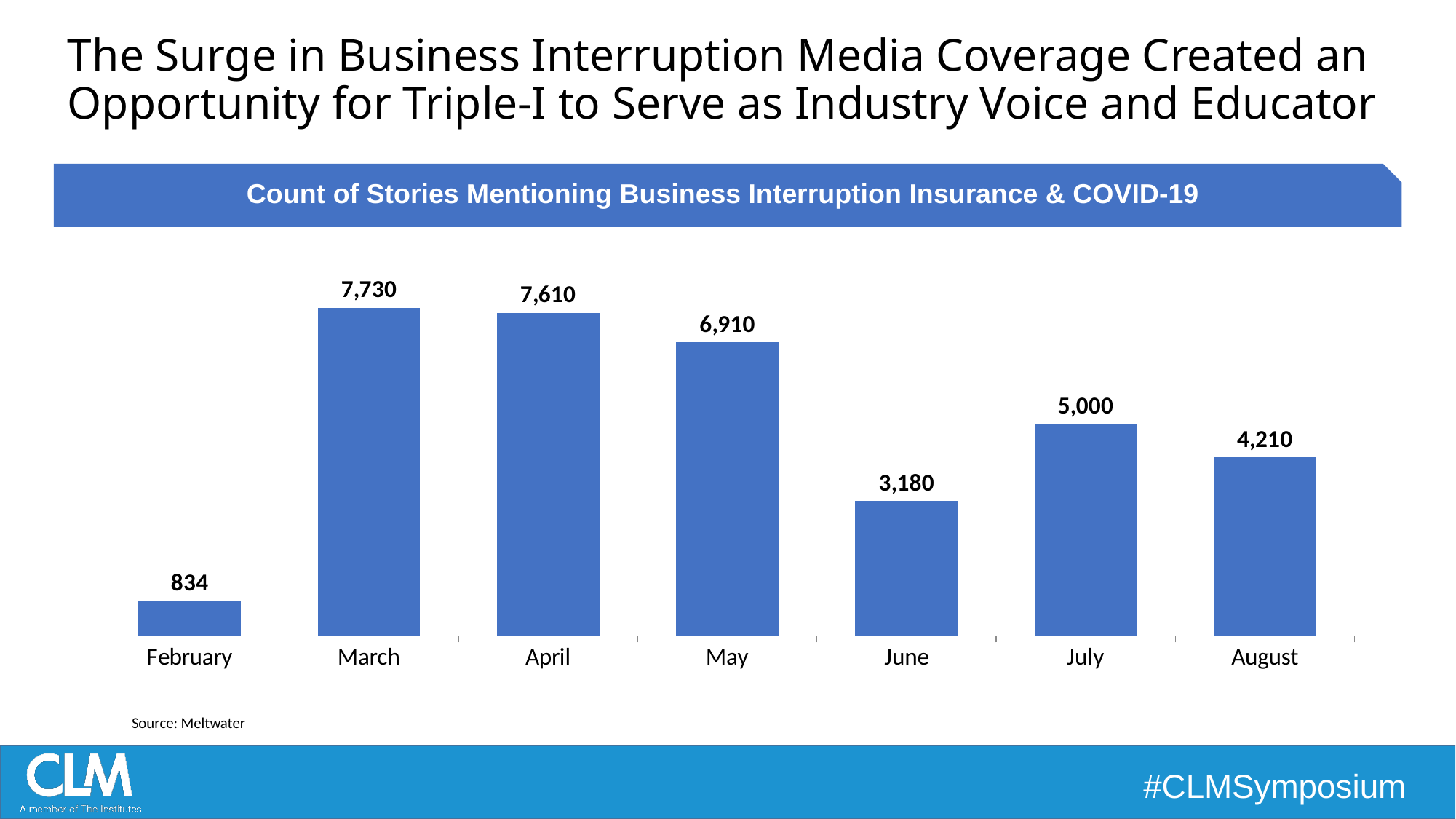
Which month has the lowest count of stories? February What kind of chart is shown on the slide? Bar chart Which month has a higher count of stories, May or July? May What is the count of stories for August? 4,210 What is the title of the chart? Count of Stories Mentioning Business Interruption Insurance & COVID-19 What is the count of stories for March? 7,730 What is the count of stories for February? 834 What is the count of stories for June? 3,180 How many months are shown on the chart? 7 What is the difference between the counts for July and June? 1,820 What is the difference between the counts for March and April? 120 Which month has the highest count of stories? March